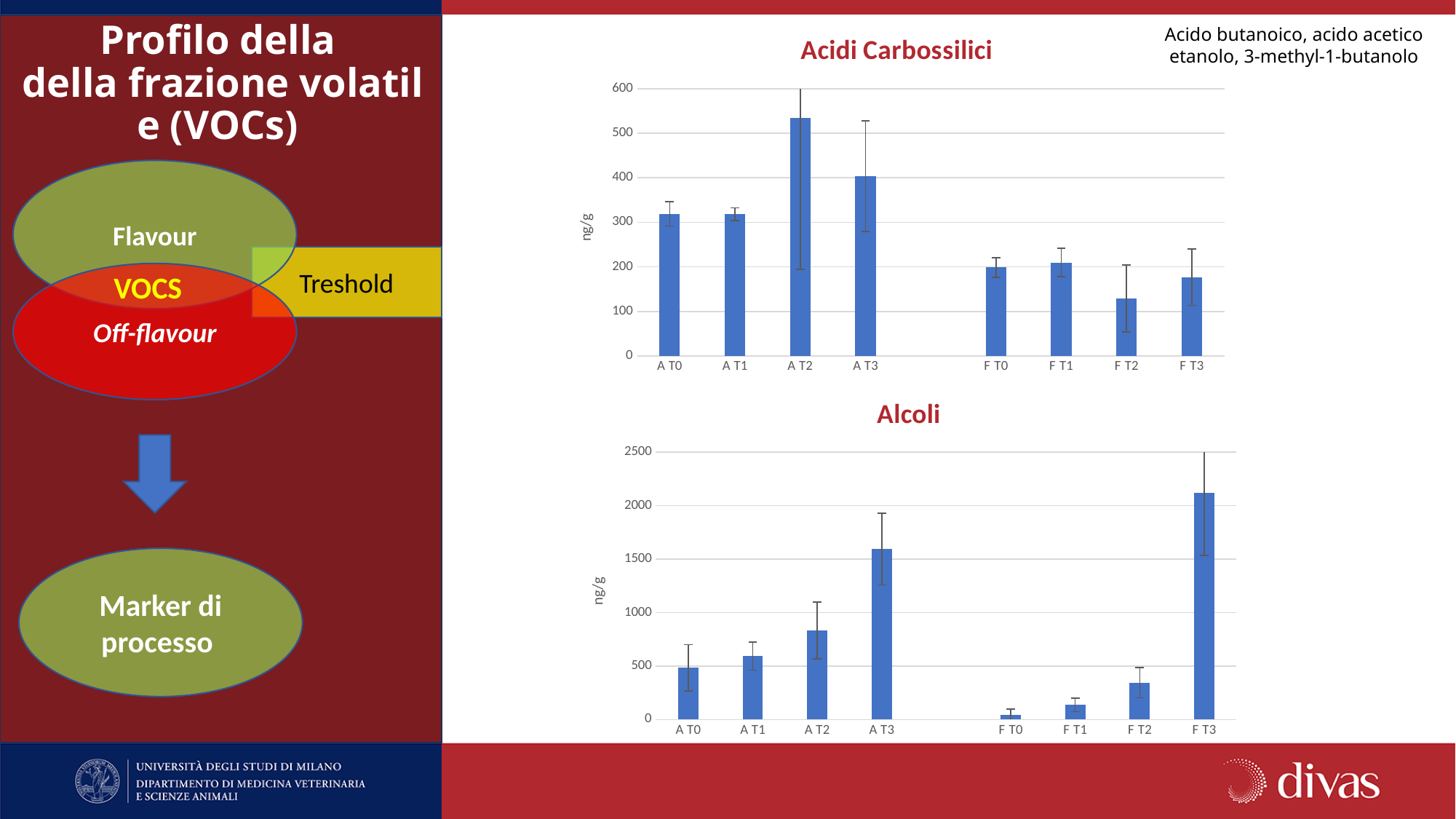
In the 'Alcoli' chart, is the value for F T3 greater or less than 2000? greater In the 'Alcoli' chart, which category has the lowest value? F T0 In the 'Alcoli' chart, which category has the highest value? F T3 How many categories are shown on the x axis of the 'Alcoli' chart? 8 In the 'Alcoli' chart, do the values rise or fall from A T0 to A T3? rise What is the y-axis label of the 'Alcoli' chart? ng/g What type of chart is the 'Acidi Carbossilici' chart? bar chart In the 'Acidi Carbossilici' chart, which category has the lowest value? F T2 In the 'Acidi Carbossilici' chart, is the value for F T2 greater or less than 100? greater In the 'Acidi Carbossilici' chart, is the value for A T2 greater or less than 500? greater In the 'Acidi Carbossilici' chart, which category has the highest value? A T2 In the 'Acidi Carbossilici' chart, which is larger, the value for A T2 or the value for F T2? A T2